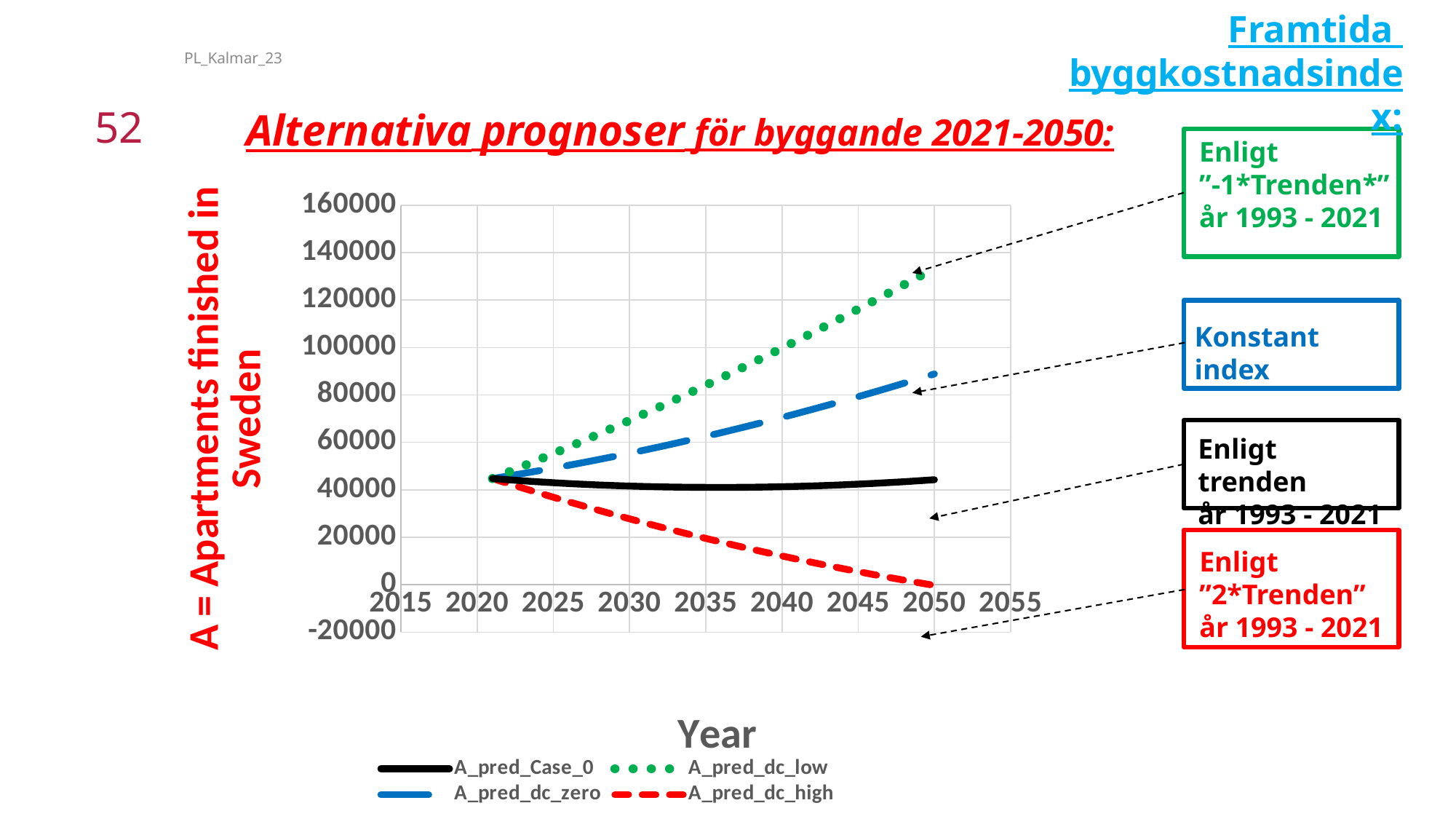
Is the value for A_pred_Case_0 in 2050 greater or less than 60000? less Is the value for A_pred_dc_high in 2050 greater or less than 20000? less Which colour is used for the A_pred_dc_high series? red Which series has the highest value in 2050? A_pred_dc_low Which series has the lowest value in 2050? A_pred_dc_high How many series does the legend list? 4 Does the A_pred_dc_low series rise or fall from 2021 to 2050? rise What kind of chart is shown on the slide? line chart What is the title of the x axis? Year In 2050, which is larger: A_pred_dc_zero or A_pred_Case_0? A_pred_dc_zero Does the A_pred_dc_high series rise or fall from 2021 to 2050? fall Is the value for A_pred_dc_low in 2050 greater or less than 120000? greater